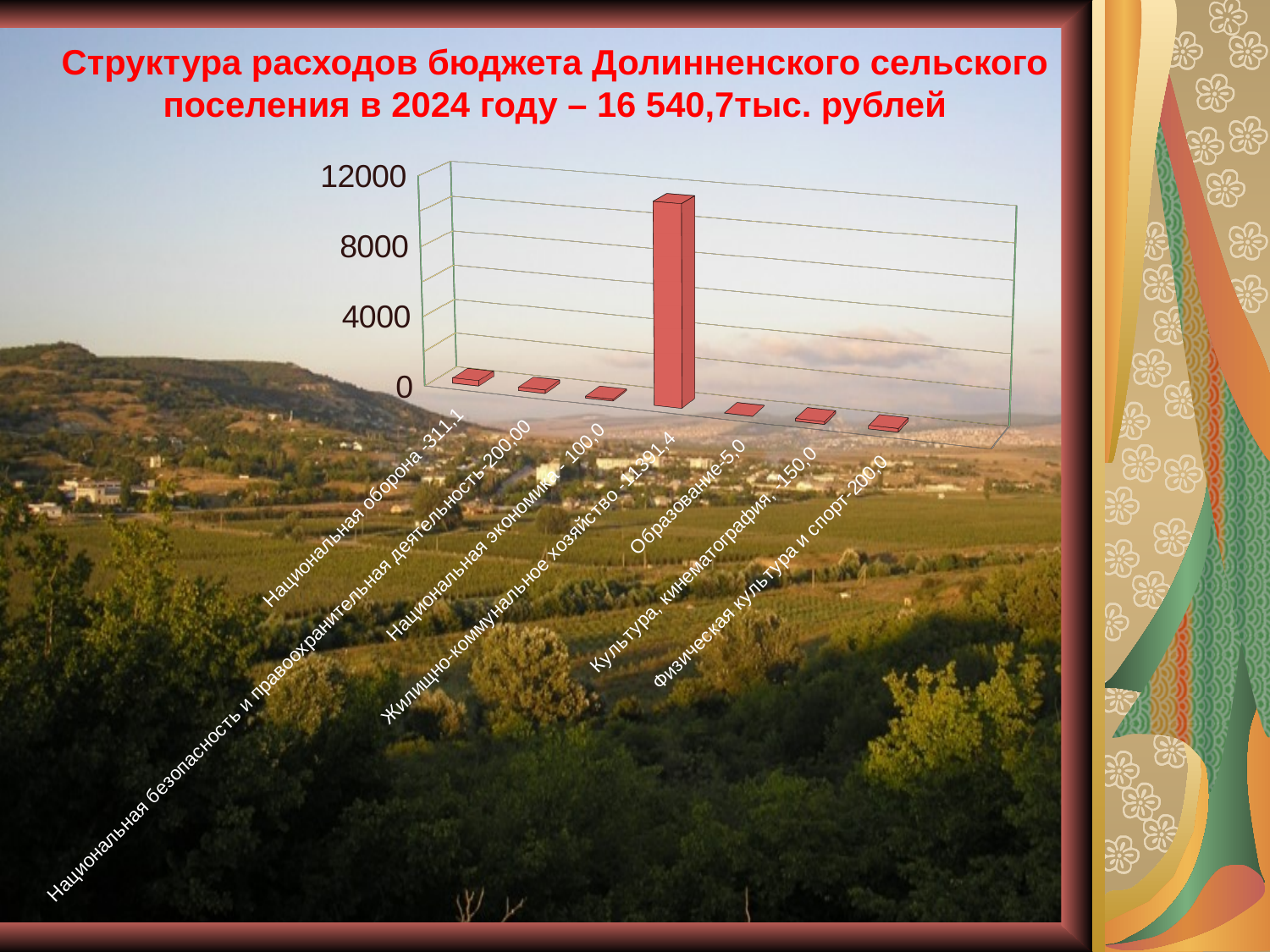
What value is shown for Культура, кинематография? 150,0 What kind of chart is shown on the slide? bar chart Which is larger: the value for Национальная оборона or the value for Национальная экономика? Национальная оборона Which category has the highest value in the chart? Жилищно-коммунальное хозяйство How many categories are plotted in the chart? 7 What total budget expenditure amount is stated in the chart title? 16 540,7тыс. рублей What value is shown for Жилищно-коммунальное хозяйство? 11391,4 What value is shown for Национальная оборона? 311,1 What is the difference between the values for Национальная оборона and Национальная экономика? 211,1 Is the value for Жилищно-коммунальное хозяйство greater or less than 8000? greater Which category has the lowest value in the chart? Образование What value is shown for Образование? 5,0